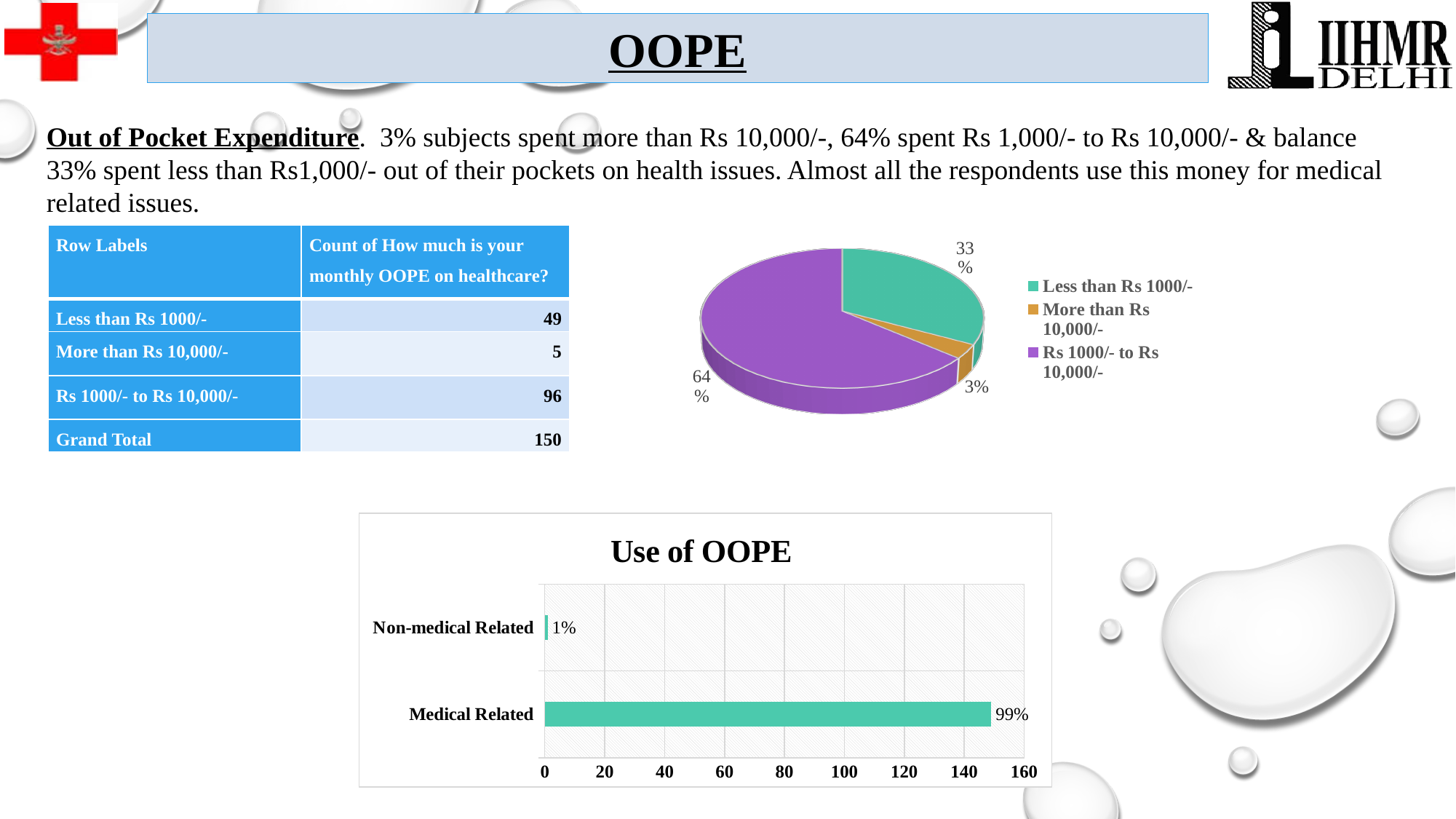
In the pie chart at the top right, how many entries does the legend list? 3 What kind of chart is the 'Use of OOPE' chart? Bar chart In the pie chart at the top right, what share of the pie is labelled for Less than Rs 1000/-? 33% In the 'Use of OOPE' chart, what is the data label on the Medical Related bar? 99% In the pie chart at the top right, what share of the pie is labelled for More than Rs 10,000/-? 3% In the pie chart at the top right, what share of the pie is labelled for Rs 1000/- to Rs 10,000/-? 64% In the 'Use of OOPE' chart, what is the data label on the Non-medical Related bar? 1% In the 'Use of OOPE' chart, how many categories are shown? 2 In the pie chart at the top right, what is the difference in percentage points between the Rs 1000/- to Rs 10,000/- slice and the Less than Rs 1000/- slice? 31 In the 'Use of OOPE' chart, is the value for Medical Related greater or less than 140? greater In the pie chart at the top right, which category has the largest slice? Rs 1000/- to Rs 10,000/- In the pie chart at the top right, which category has the smallest slice? More than Rs 10,000/-